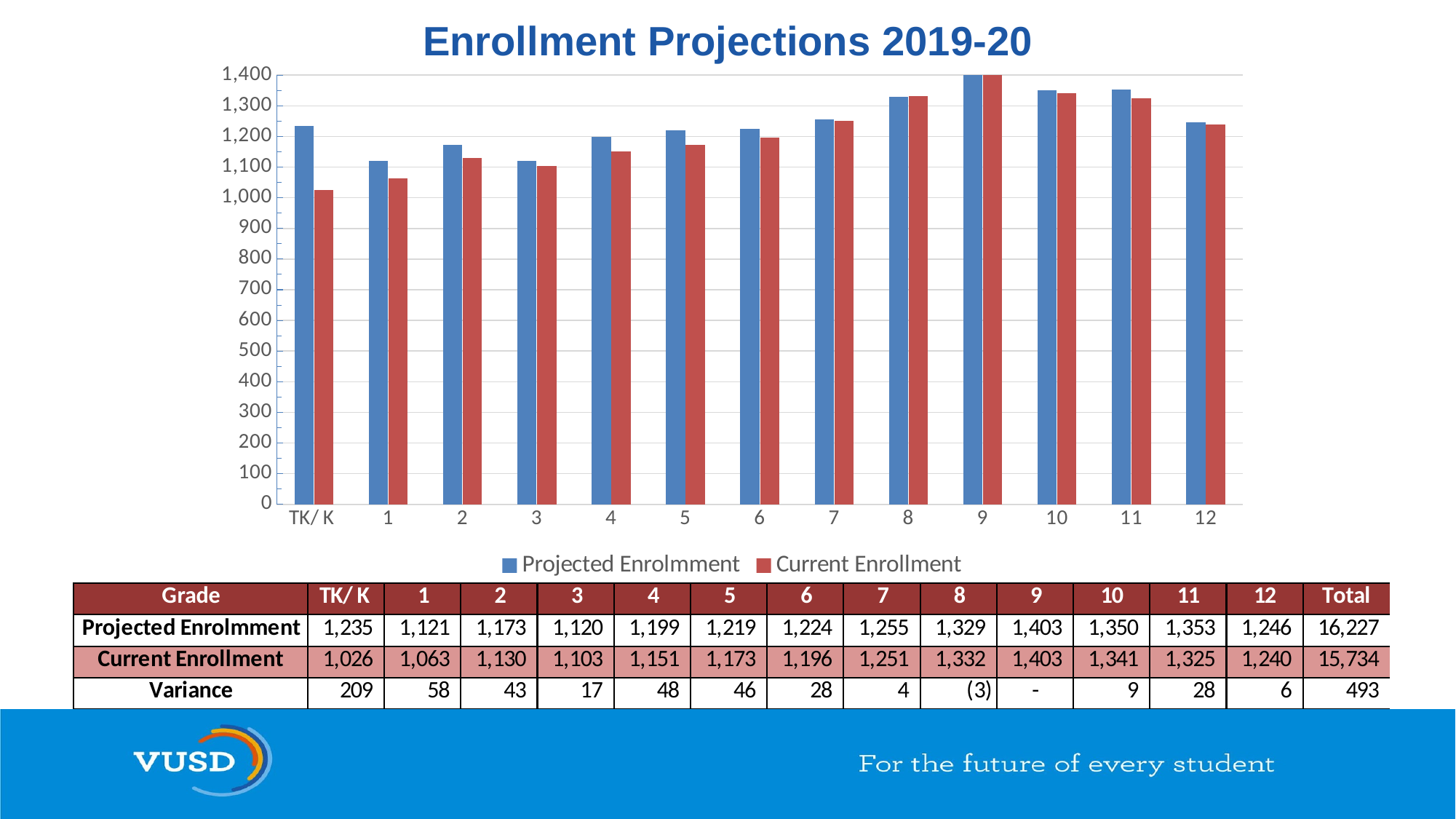
How many series does the legend list? 2 What is the Projected Enrolmment value for grade 9? 1,403 What is the Total Projected Enrolmment shown in the table? 16,227 What is the title of the chart? Enrollment Projections 2019-20 Which grade has the lowest Current Enrollment? TK/K Which grade has the highest Current Enrollment? 9 What is the difference between Projected Enrolmment and Current Enrollment for TK/K? 209 Is the Projected Enrolmment value for grade 9 greater or less than 1,300? greater What is the Current Enrollment value for TK/K? 1,026 For grade 4, which is larger: Projected Enrolmment or Current Enrollment? Projected Enrolmment What kind of chart is shown on the slide? bar chart How many grade categories are plotted along the x axis? 13